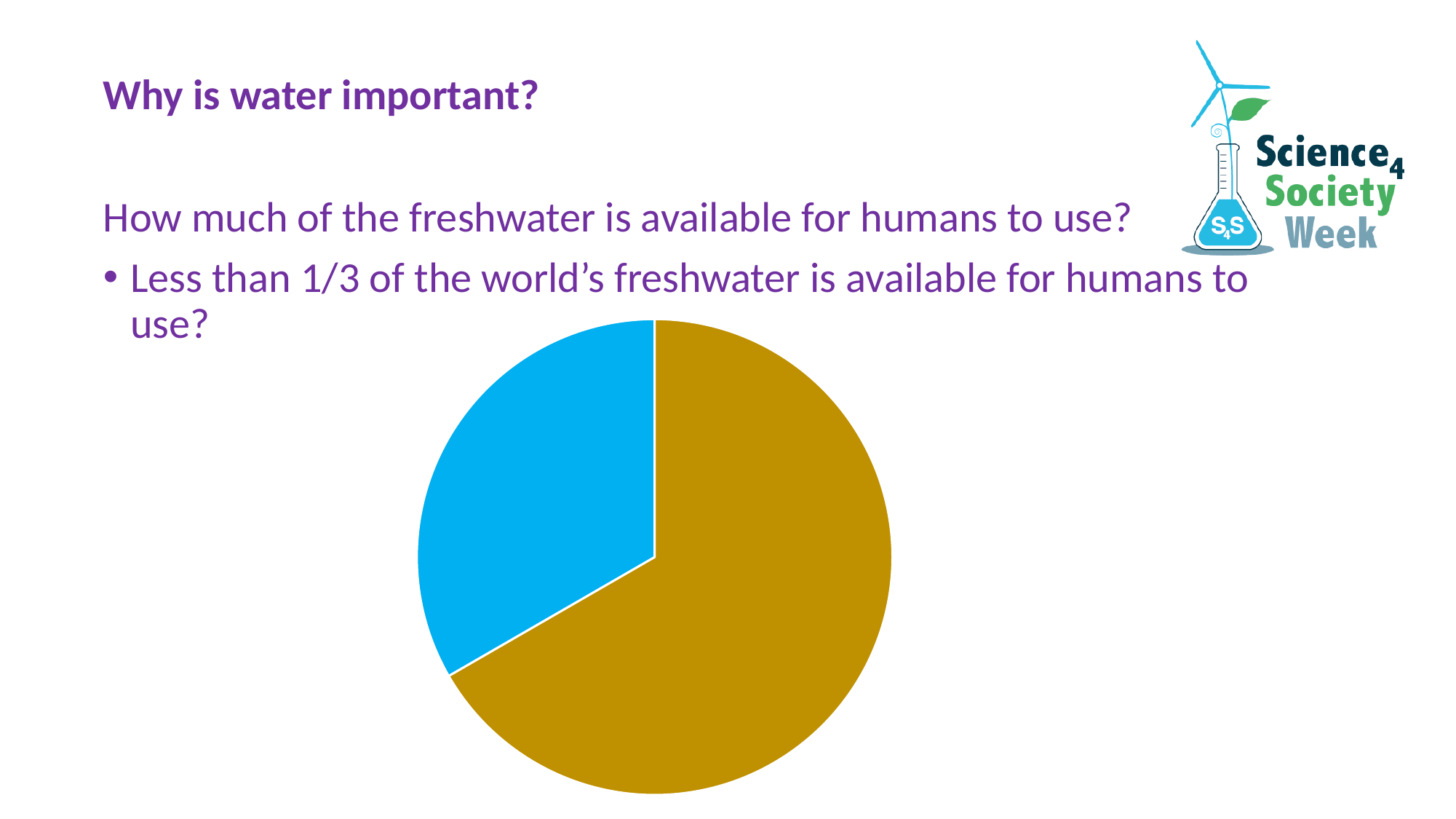
Which colour slice takes up the largest share of the pie chart? gold What two colours are used for the slices of the pie chart? blue and gold What kind of chart is shown on the slide? pie chart Is the blue slice of the pie chart greater or less than half of the pie? less Does the pie chart display a legend? No Which slice of the pie chart is larger, the blue slice or the gold slice? the gold slice Is the gold slice of the pie chart greater or less than half of the pie? greater Which colour slice takes up the smallest share of the pie chart? blue How many slices does the pie chart have? 2